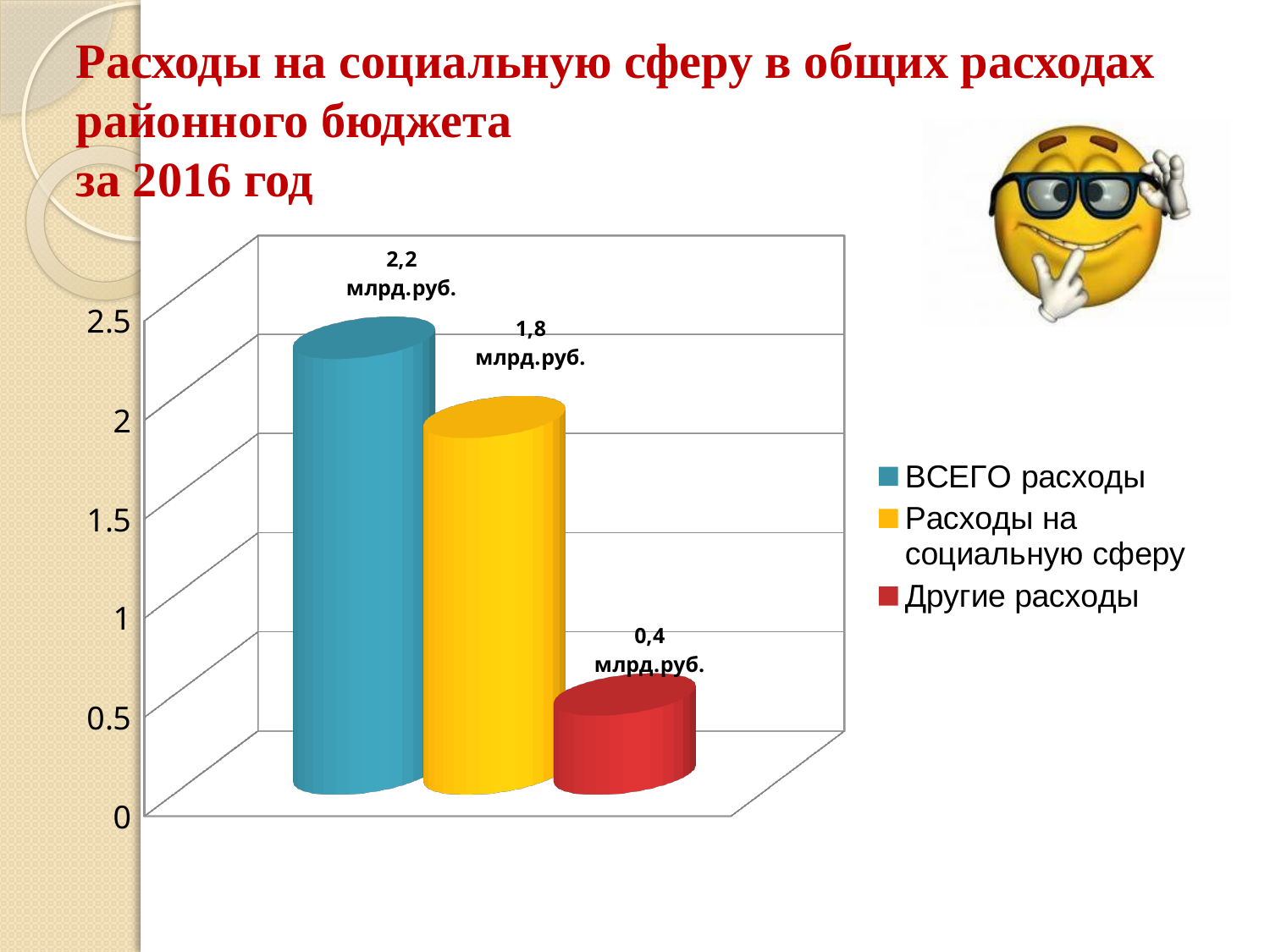
What kind of chart is shown on the slide? bar chart Is the value for Другие расходы greater or less than 1? less What is the value for Расходы на социальную сферу? 1,8 млрд.руб. What is the value for Другие расходы? 0,4 млрд.руб. Which series has the highest value? ВСЕГО расходы What is the difference between Расходы на социальную сферу and Другие расходы? 1,4 млрд.руб. What colour is the bar for Расходы на социальную сферу? yellow How many series does the legend list? 3 What is the value for ВСЕГО расходы? 2,2 млрд.руб. Which series has the lowest value? Другие расходы What is the difference between ВСЕГО расходы and Расходы на социальную сферу? 0,4 млрд.руб. Which is larger, Расходы на социальную сферу or Другие расходы? Расходы на социальную сферу